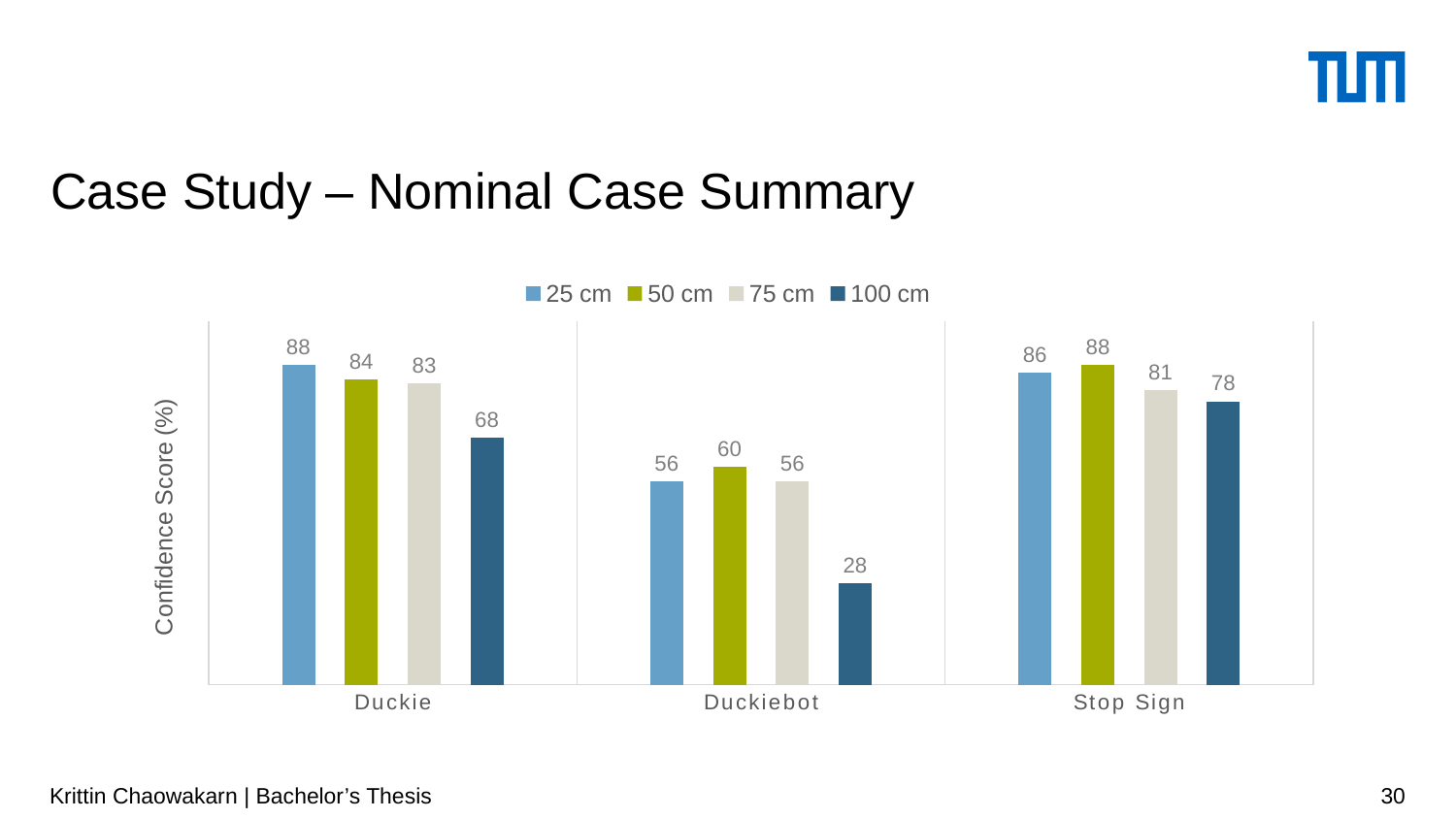
Which is larger, the confidence score for Duckiebot at 50 cm or for Stop Sign at 100 cm? Stop Sign at 100 cm What is the confidence score for Duckie at 25 cm? 88 What is the confidence score for Stop Sign at 75 cm? 81 What is the difference between the confidence scores for Duckie at 25 cm and at 100 cm? 20 What is the label of the y axis? Confidence Score (%) What is the confidence score for Duckiebot at 100 cm? 28 Which distance gives the highest confidence score for Stop Sign? 50 cm Which distance gives the lowest confidence score for Duckiebot? 100 cm How many series does the legend list? 4 What kind of chart is shown on the slide? Bar chart Do the confidence scores for Duckiebot rise or fall from 75 cm to 100 cm? Fall How many object categories are shown on the x axis? 3